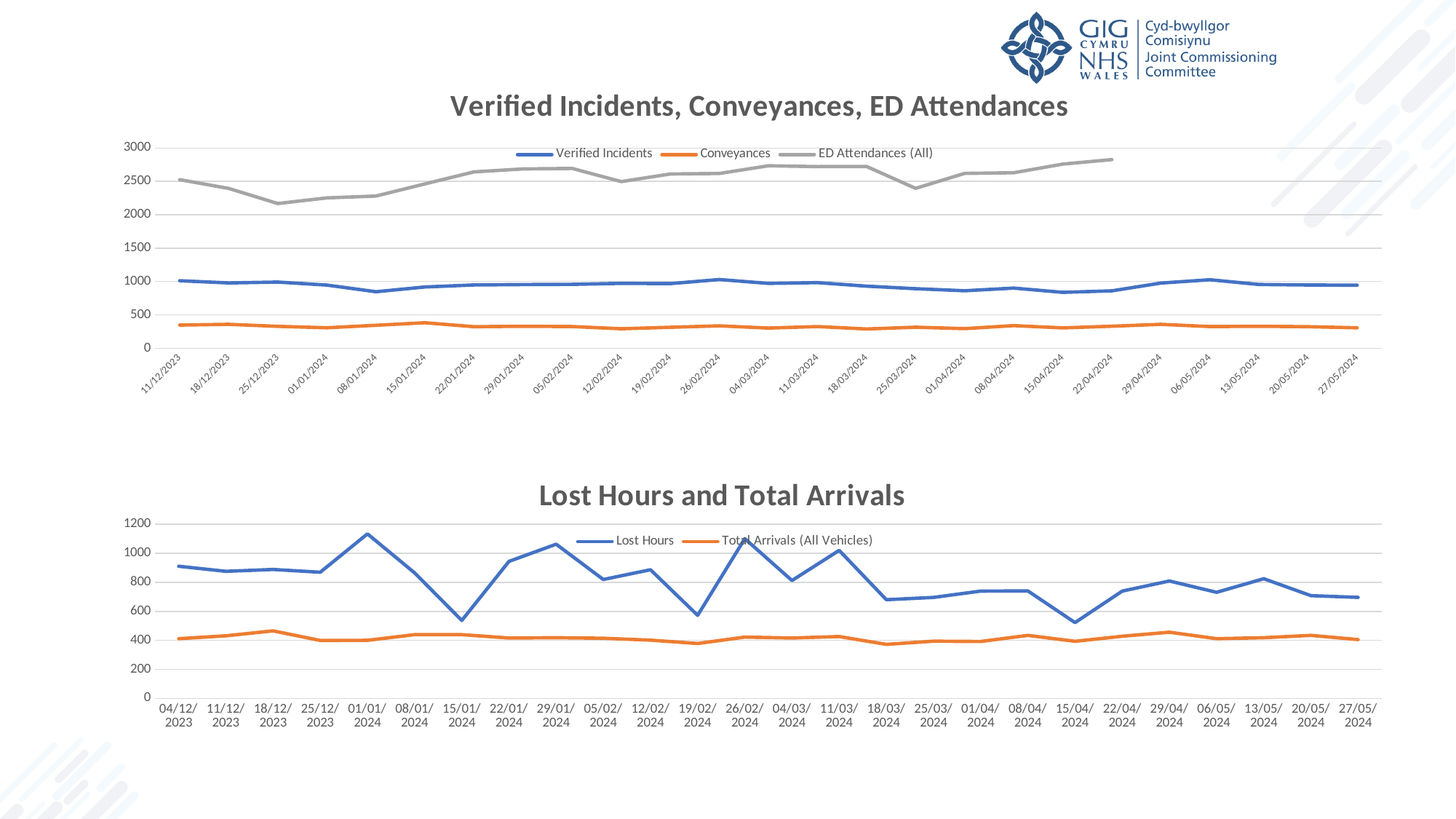
In the 'Verified Incidents, Conveyances, ED Attendances' chart, is the ED Attendances (All) value for 25/12/2023 greater or less than 2500? less How many series does the legend of the 'Verified Incidents, Conveyances, ED Attendances' chart list? 3 In the 'Lost Hours and Total Arrivals' chart, is the Lost Hours value for 15/01/2024 greater or less than 600? less In the 'Verified Incidents, Conveyances, ED Attendances' chart, on which date is ED Attendances (All) highest? 22/04/2024 In the 'Verified Incidents, Conveyances, ED Attendances' chart, which series is higher on 11/12/2023: Verified Incidents or Conveyances? Verified Incidents How many series does the legend of the 'Lost Hours and Total Arrivals' chart list? 2 What colour is the Total Arrivals (All Vehicles) line in the 'Lost Hours and Total Arrivals' chart? Orange In the 'Verified Incidents, Conveyances, ED Attendances' chart, on which date is ED Attendances (All) lowest? 25/12/2023 In the 'Lost Hours and Total Arrivals' chart, is the Lost Hours value for 01/01/2024 greater or less than 1000? greater What type of chart is the 'Verified Incidents, Conveyances, ED Attendances' chart? Line chart How many dates are plotted along the x axis of the 'Lost Hours and Total Arrivals' chart? 26 How many dates are plotted along the x axis of the 'Verified Incidents, Conveyances, ED Attendances' chart? 25